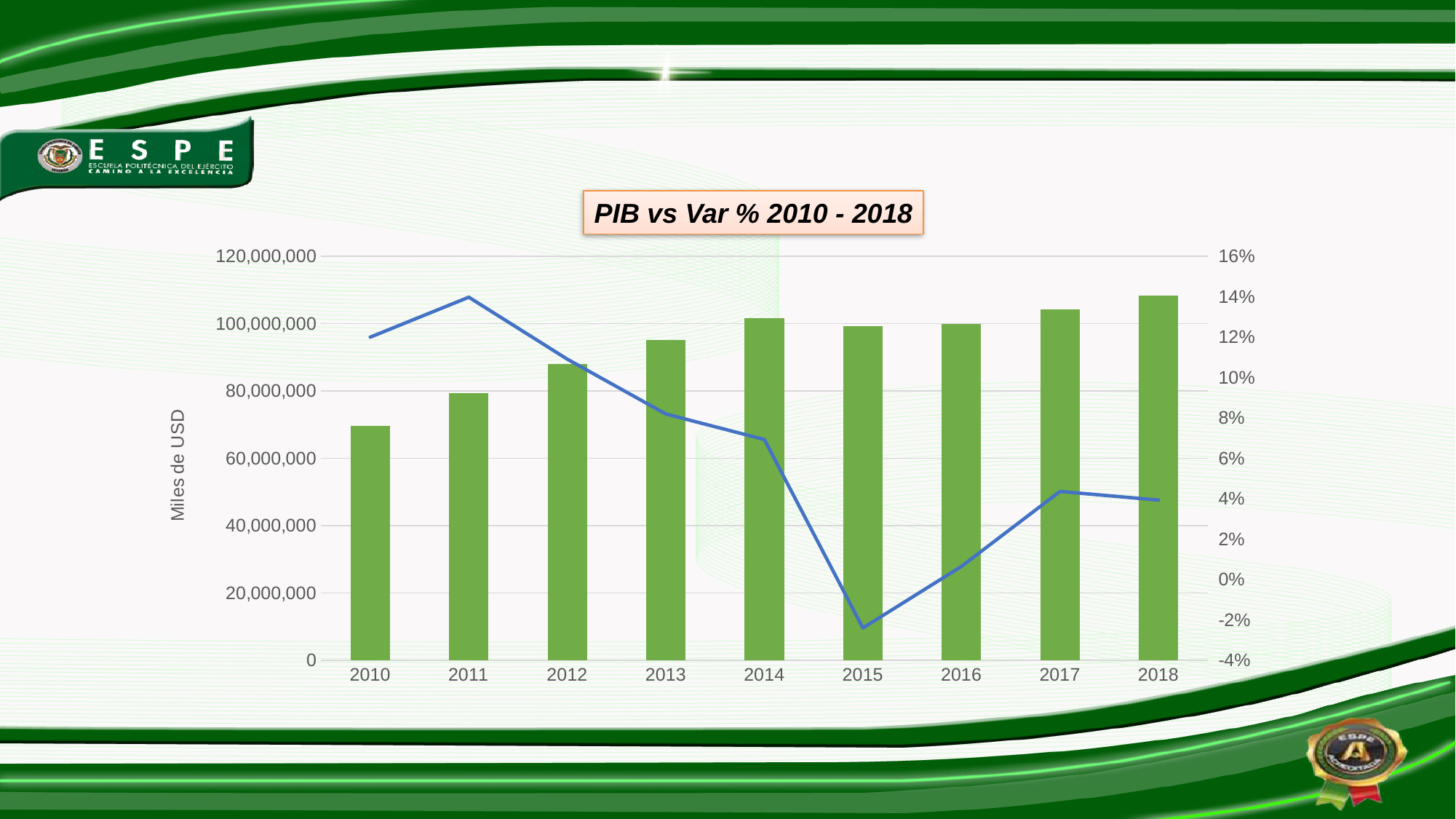
In which year does the line reach its lowest point? 2015 How many years are shown on the x axis of the chart? 9 What is the label on the left vertical axis of the chart? Miles de USD In which year does the line reach its highest point? 2011 Is the line value for 2015 greater or less than 0%? less Is the bar value for 2010 greater or less than 80,000,000? less Is the bar value for 2018 greater or less than 100,000,000? greater What kind of chart is shown on the slide? A combined bar and line chart Which year has the tallest bar in the chart? 2018 What is the title of the chart? PIB vs Var % 2010 - 2018 Which year has the shortest bar in the chart? 2010 Which bar is taller, 2013 or 2014? 2014